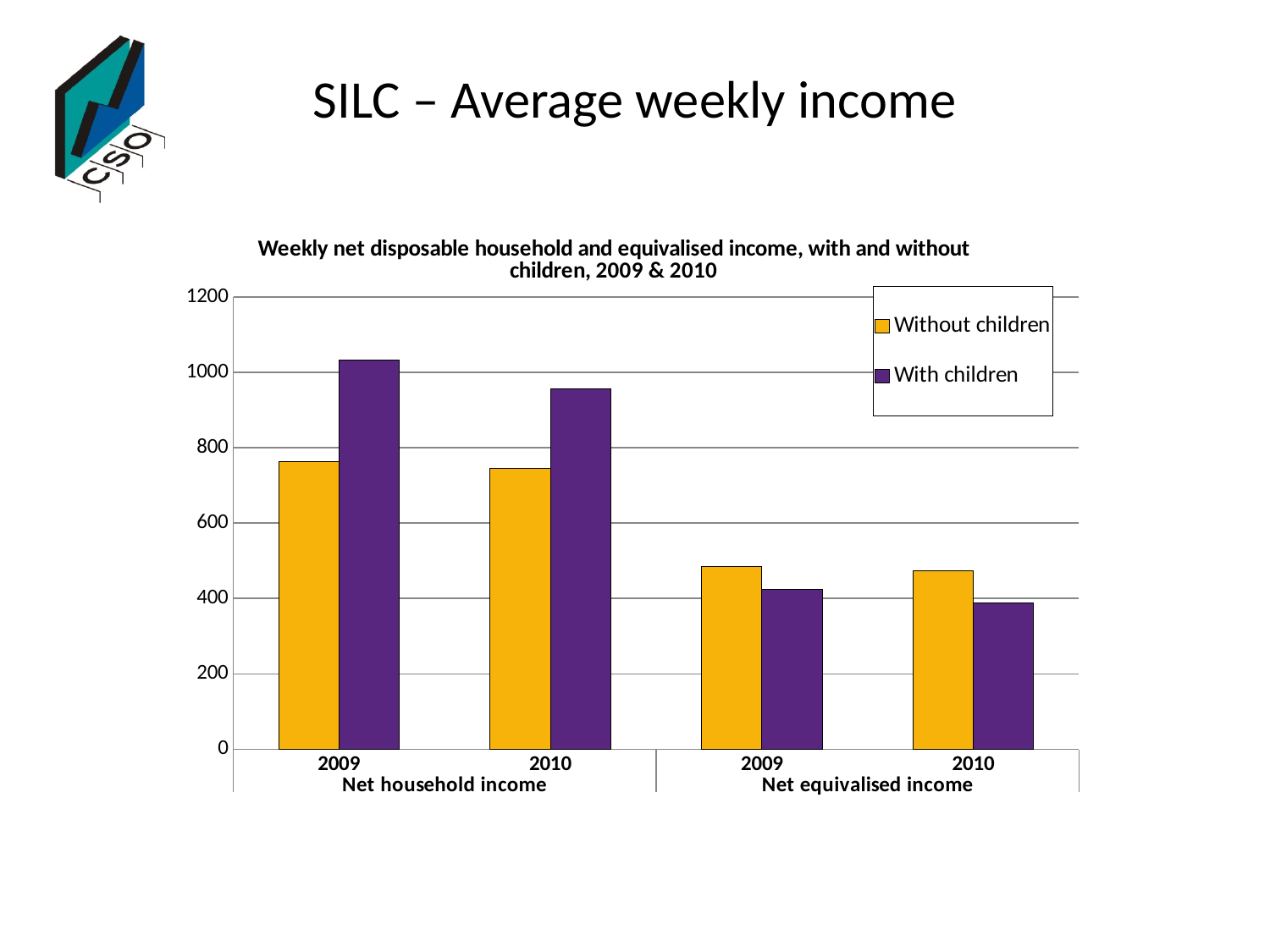
Under Net equivalised income in 2009, which is larger: With children or Without children? Without children Is the value for With children under Net household income in 2009 greater or less than 1000? greater Which series is shown in purple? With children Is the value for Without children under Net equivalised income in 2009 greater or less than 400? greater Is the value for Without children under Net household income in 2009 greater or less than 800? less What kind of chart is shown on the slide? bar chart Which bar is the highest in the chart? With children, Net household income, 2009 Does the With children value for Net household income rise or fall from 2009 to 2010? fall Under Net household income in 2009, which is larger: With children or Without children? With children How many series does the legend list? 2